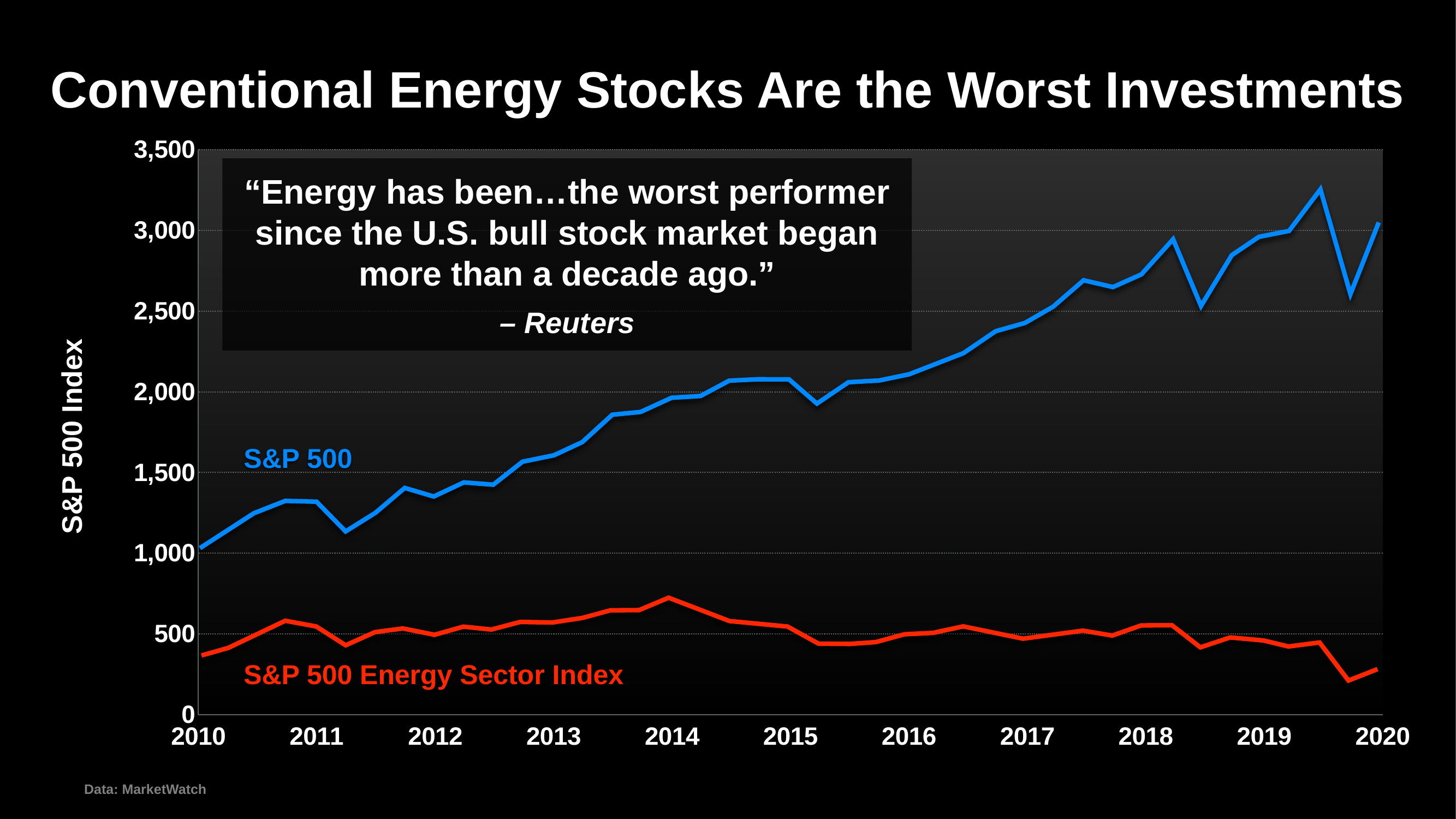
Does the S&P 500 Energy Sector Index line rise or fall from 2014 to 2020? Fall Does the S&P 500 line generally rise or fall from 2010 to 2020? Rise How many series are plotted on the chart? 2 What are the names of the two series plotted on the chart? S&P 500 and S&P 500 Energy Sector Index What is the label on the vertical axis of the chart? S&P 500 Index How many years are labeled on the x axis of the chart? 11 In which year does the S&P 500 Energy Sector Index reach its highest point? 2014 What kind of chart is shown on the slide? Line chart Is the value of the S&P 500 Energy Sector Index in 2020 greater or less than 500? less Is the value of the S&P 500 Energy Sector Index in 2014 greater or less than 500? greater Which series has the higher value in 2020, S&P 500 or S&P 500 Energy Sector Index? S&P 500 Is the value of the S&P 500 in 2017 greater or less than 2,000? greater